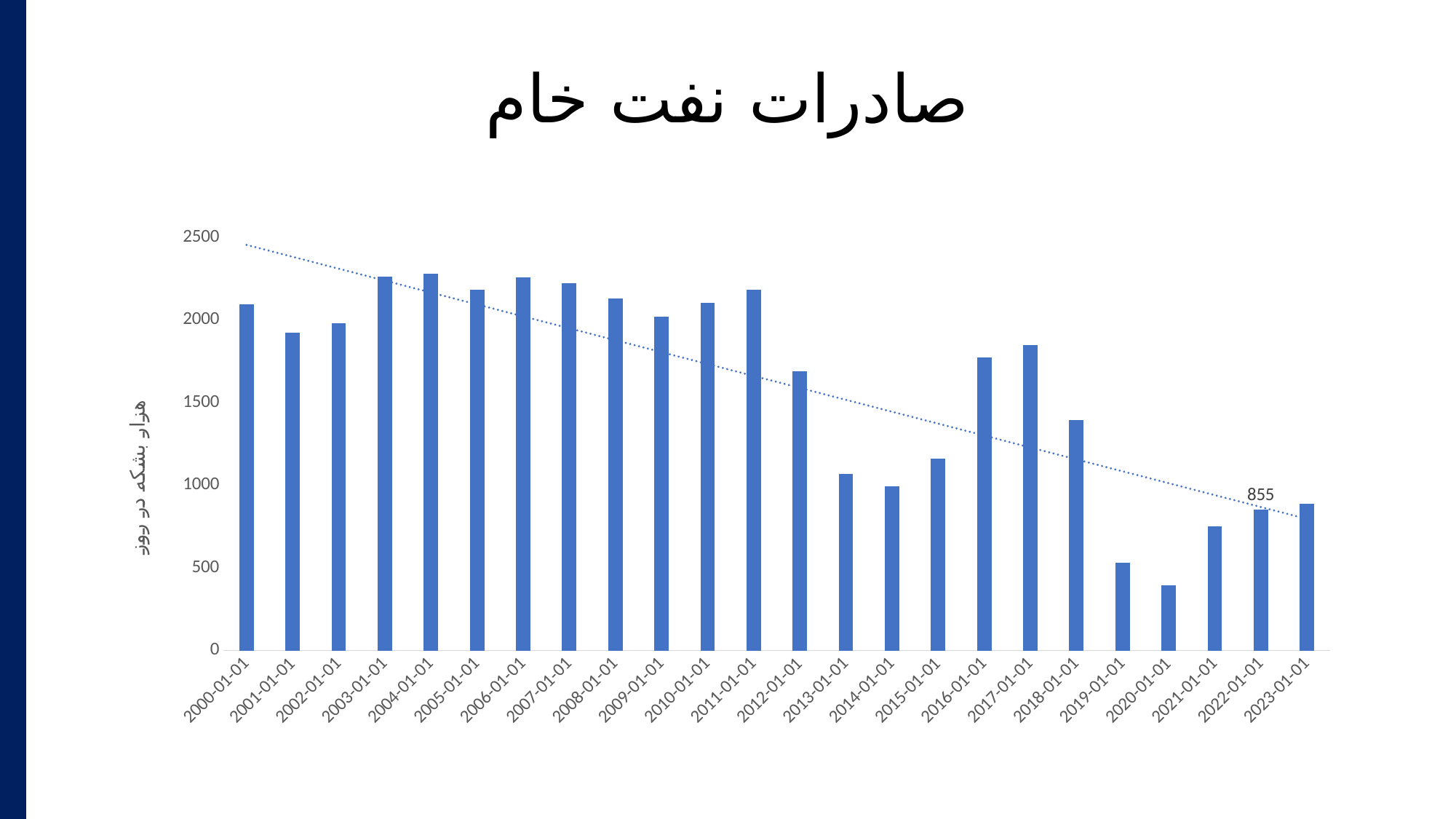
What kind of chart is shown on the slide? bar chart Overall, do the values rise or fall from 2000-01-01 to 2023-01-01? fall What is the label on the vertical axis of the chart? هزار بشکه در روز Is the value for 2020-01-01 greater or less than 500? less Which is larger, the value for 2016-01-01 or the value for 2017-01-01? 2017-01-01 Is the value for 2018-01-01 greater or less than 1500? less How many bars (years) are plotted in the chart? 24 Is the value for 2000-01-01 greater or less than 2000? greater Which year has the lowest value in the chart? 2020-01-01 What is the value for 2022-01-01? 855 What is the title of the chart? صادرات نفت خام